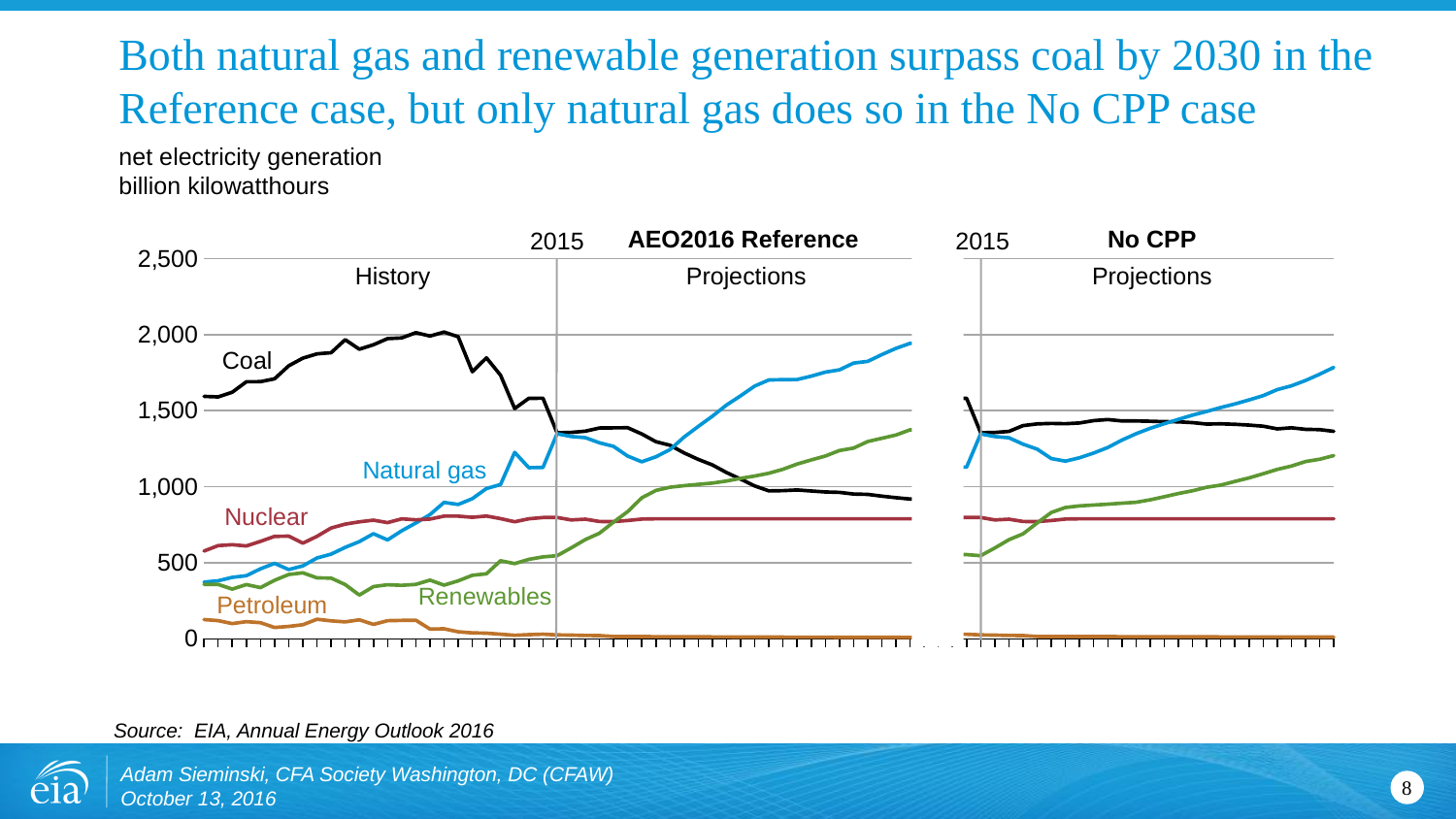
In the AEO2016 Reference panel, at the end of the projections, is coal or renewables larger? Renewables In the AEO2016 Reference panel, is the value for coal at the end of the projections greater or less than 1,000? less In the No CPP panel, does renewables generation rise or fall over the projection period? rise In the AEO2016 Reference panel, does coal generation rise or fall over the projection period? fall In the AEO2016 Reference panel, which series is highest at the end of the projection period? Natural gas Which series is lowest across the whole chart? Petroleum What unit is net electricity generation measured in on the chart? billion kilowatthours What kind of chart is shown on the slide? line chart In the AEO2016 Reference panel, is the value for natural gas at the end of the projections greater or less than 1,500? greater How many fuel series are labeled on the chart? 5 In the No CPP panel, at the end of the projections, is coal or renewables larger? Coal In the No CPP panel, which series is highest at the end of the projection period? Natural gas